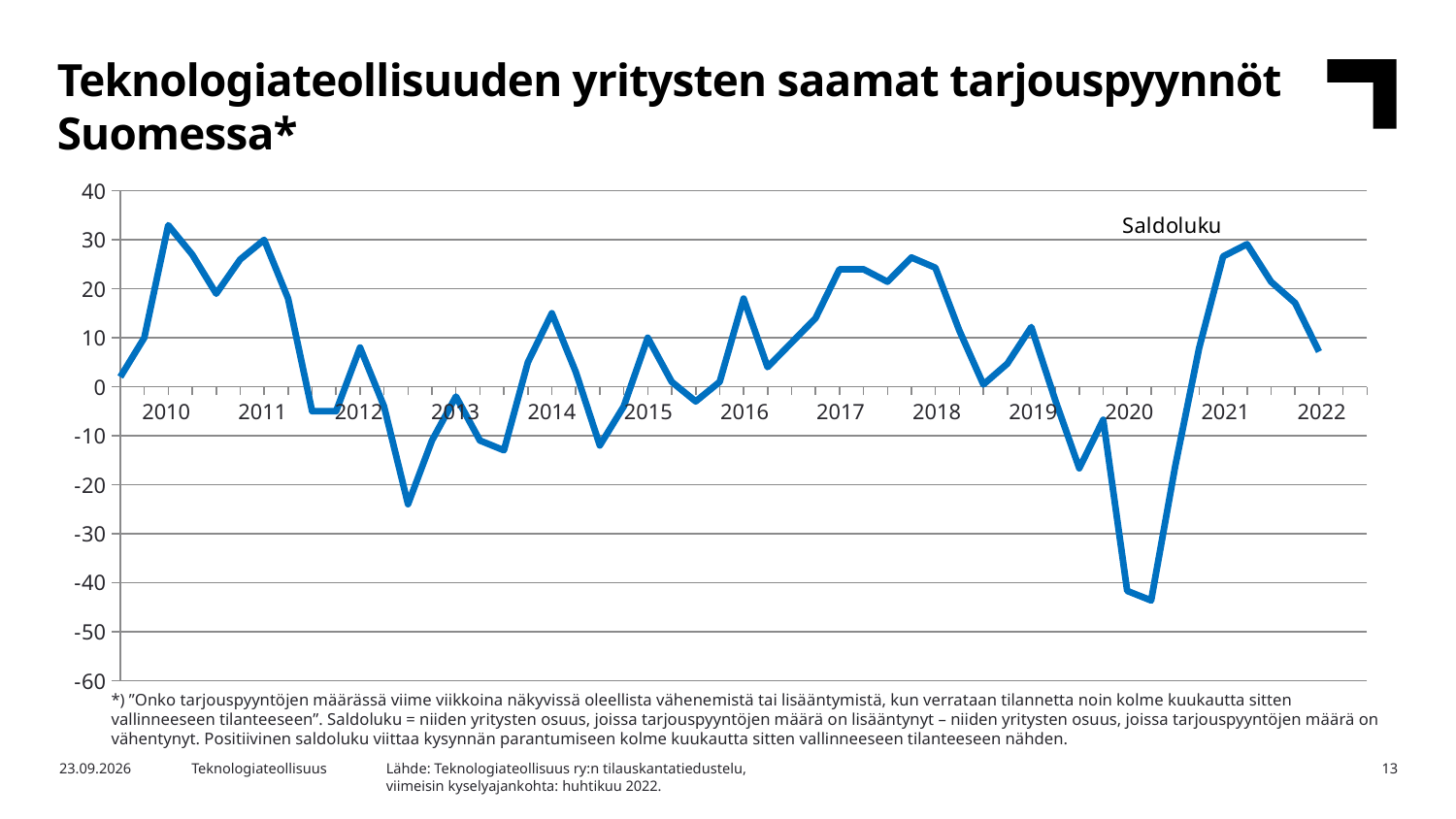
Does the line rise or fall between its 2021 peak and the end of 2022? fall Is the lowest value of the line, reached in 2020, greater or less than -30? less Does the line rise or fall between its 2020 low point and 2021? rise Is the peak value of the line in 2010 greater or less than 20? greater What is the name of the series shown in the chart? Saldoluku What is the title of the chart on the slide? Teknologiateollisuuden yritysten saamat tarjouspyynnöt Suomessa* What kind of chart is shown on the slide? line chart Is the lowest value of the line in 2012 greater or less than -20? less How many year labels are shown on the x axis? 13 In which year does the line reach its lowest point? 2020